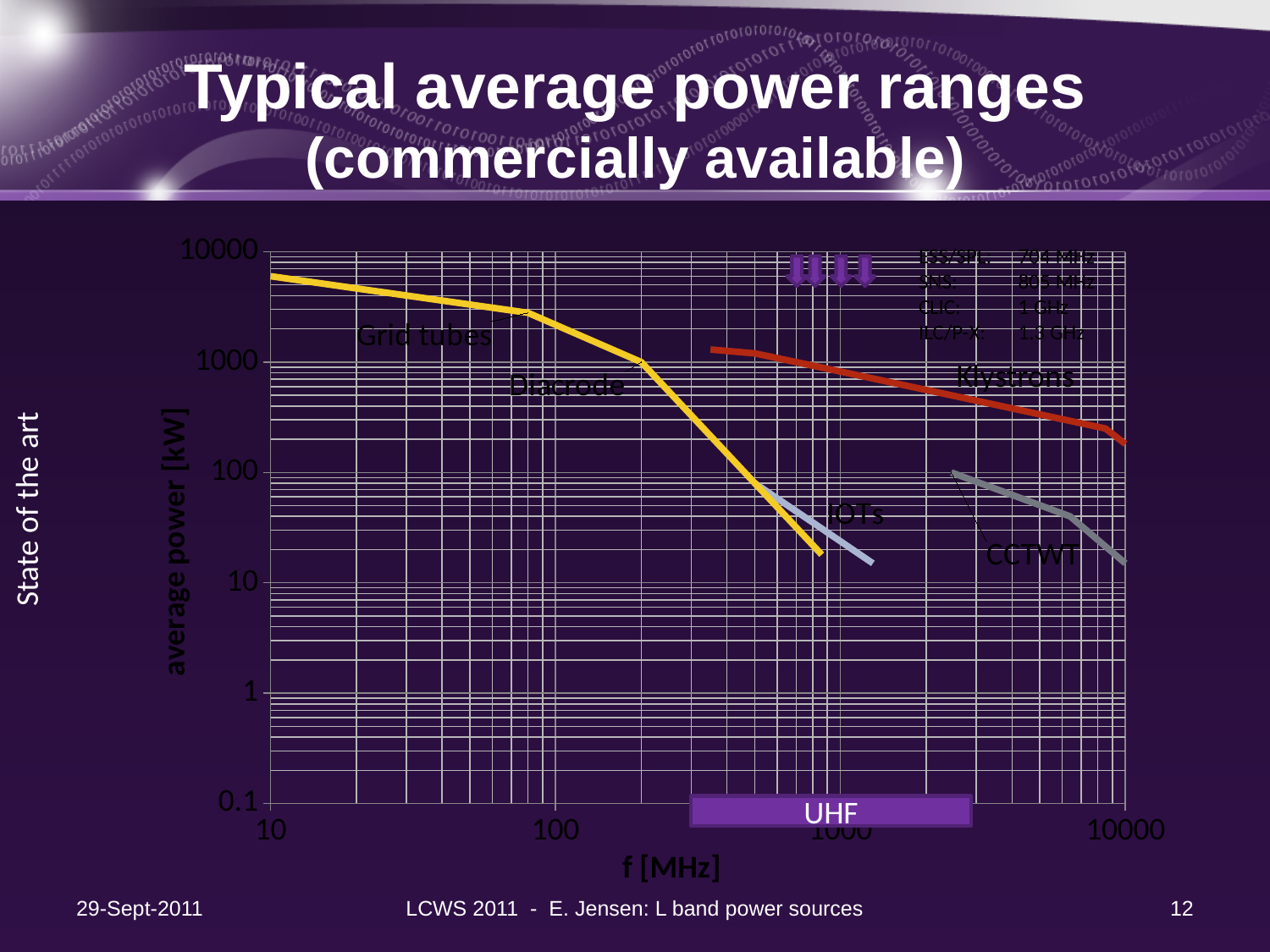
How many tick labels are shown on the y axis of the chart? 6 What kind of chart is shown on the slide? line chart Is the average power of CCTWT at 10000 MHz greater or less than 100 kW? less Does the average power of Klystrons rise or fall as frequency increases? fall What is the title of the chart on the slide? Typical average power ranges (commercially available) What is the label of the y axis of the chart? average power [kW] Is the average power of Grid tubes at 10 MHz greater or less than 1000 kW? greater Is the average power of Klystrons at 1000 MHz greater or less than 100 kW? greater Which labelled curve reaches the highest average power on the chart? Grid tubes At 1000 MHz, which has the higher average power, Klystrons or IOTs? Klystrons